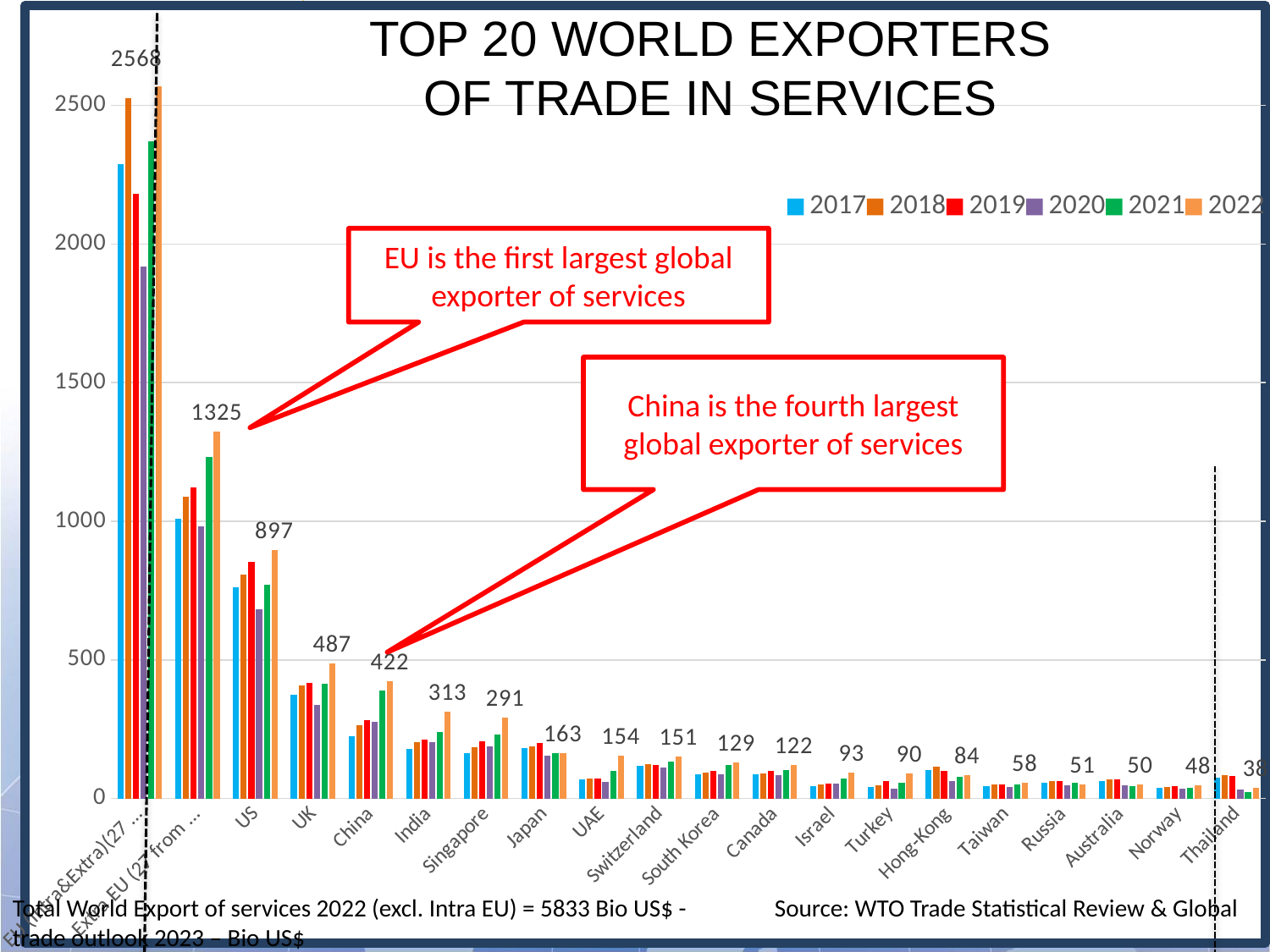
What kind of chart is shown? bar chart Which country has the lowest 2022 value? Thailand What is the 2022 value for the US? 897 What is the difference between the 2022 values for Israel and Turkey? 3 What is the 2022 value for China? 422 What is the difference between the 2022 values for the UK and China? 65 Which has the larger 2022 value, Singapore or Japan? Singapore How many series does the legend list? 6 Is the 2017 value for China greater or less than 500? less What is the 2022 value for India? 313 Do the 2022 values rise or fall moving from left to right along the x axis? fall What is the 2022 value for Hong-Kong? 84